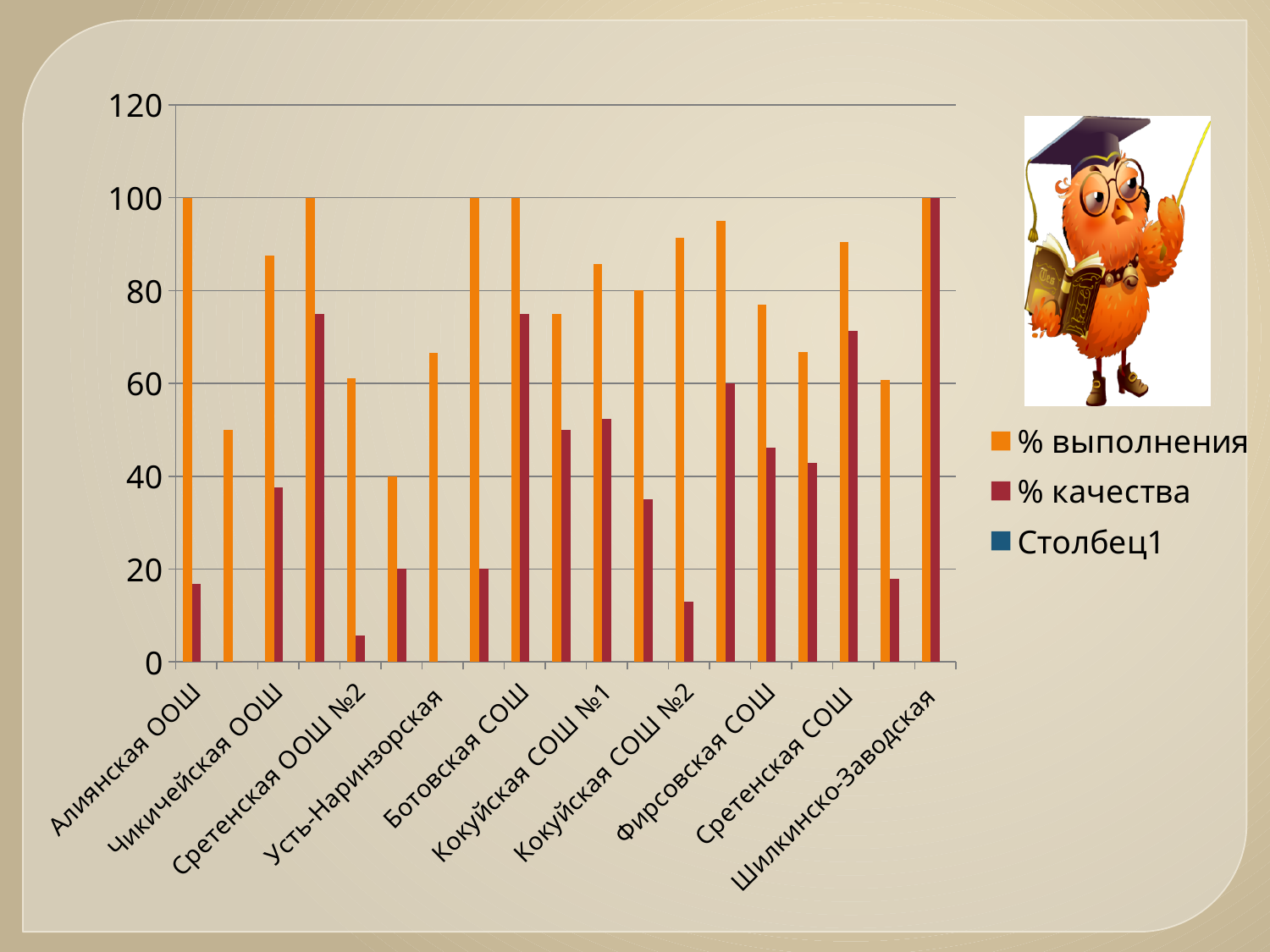
What kind of chart is shown on the slide? bar chart Is the % выполнения value for Сретенская ООШ №2 greater or less than 80? less Is the % качества value for Ботовская СОШ greater or less than 60? greater What is the % выполнения value for Алиянская ООШ? 100 What are the legend entries of the chart? % выполнения, % качества, Столбец1 How many series does the legend list? 3 Which has the higher % качества value, Сретенская СОШ or Фирсовская СОШ? Сретенская СОШ Which has the higher % качества value, Ботовская СОШ or Кокуйская СОШ №1? Ботовская СОШ What is the highest value shown on the vertical axis? 120 What is the % выполнения value for Шилкинско-Заводская? 100 Is the % качества value for Алиянская ООШ greater or less than 20? less